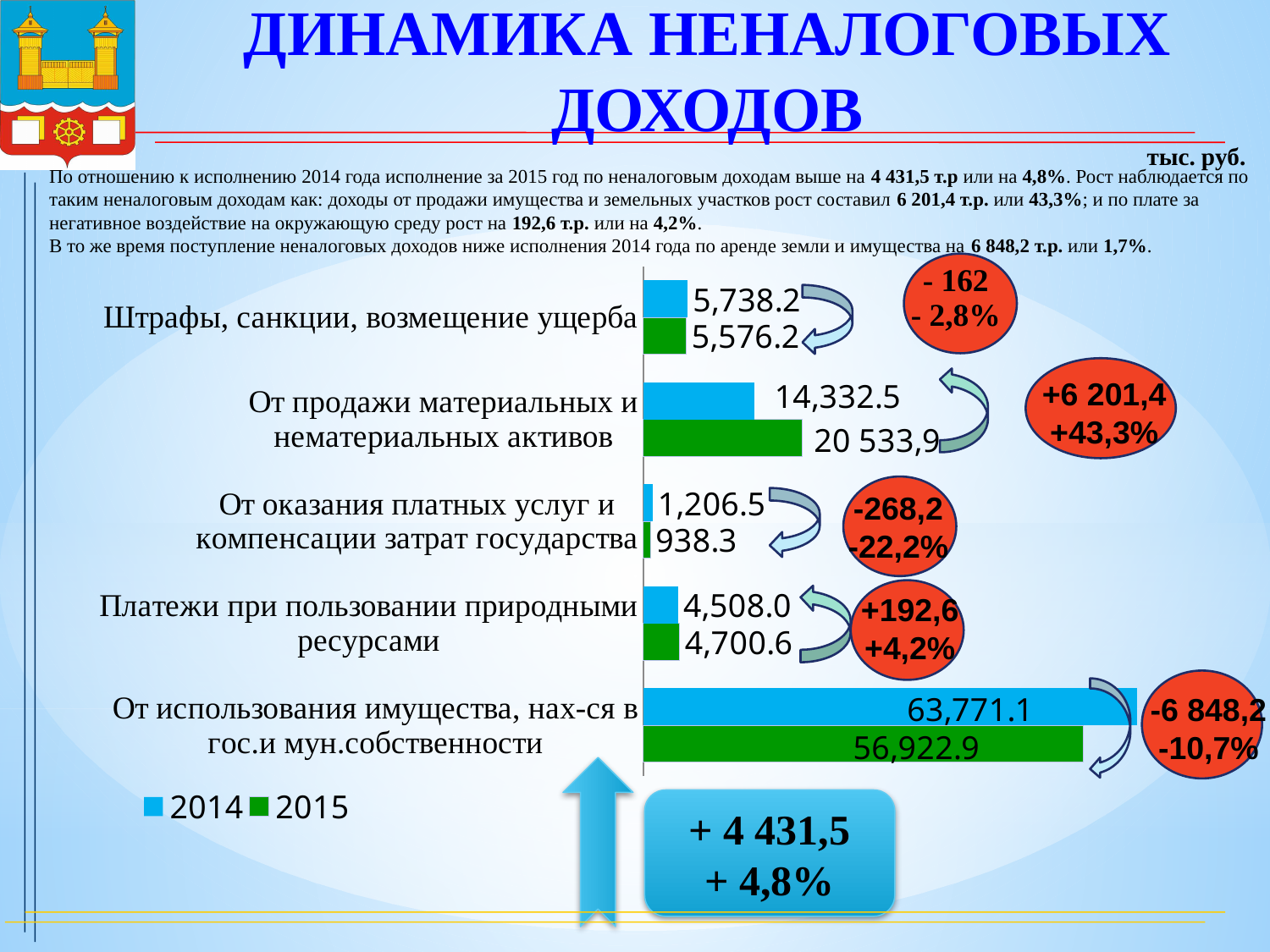
How many series does the legend list? 2 For «От продажи материальных и нематериальных активов», which year has the larger value, 2014 or 2015? 2015 Which category has the highest 2014 value? От использования имущества, нах-ся в гос.и мун.собственности What is the 2014 value for «Платежи при пользовании природными ресурсами»? 4,508.0 How many categories are shown in the chart? 5 What is the 2015 value for «От оказания платных услуг и компенсации затрат государства»? 938.3 What is the difference between the 2015 and 2014 values for «Платежи при пользовании природными ресурсами»? 192.6 Which category has the lowest 2015 value? От оказания платных услуг и компенсации затрат государства What is the 2015 value for «От продажи материальных и нематериальных активов»? 20 533,9 What is the 2014 value for «Штрафы, санкции, возмещение ущерба»? 5,738.2 What kind of chart is shown on the slide? Bar chart What is the difference between the 2014 and 2015 values for «От использования имущества, нах-ся в гос.и мун.собственности»? 6,848.2